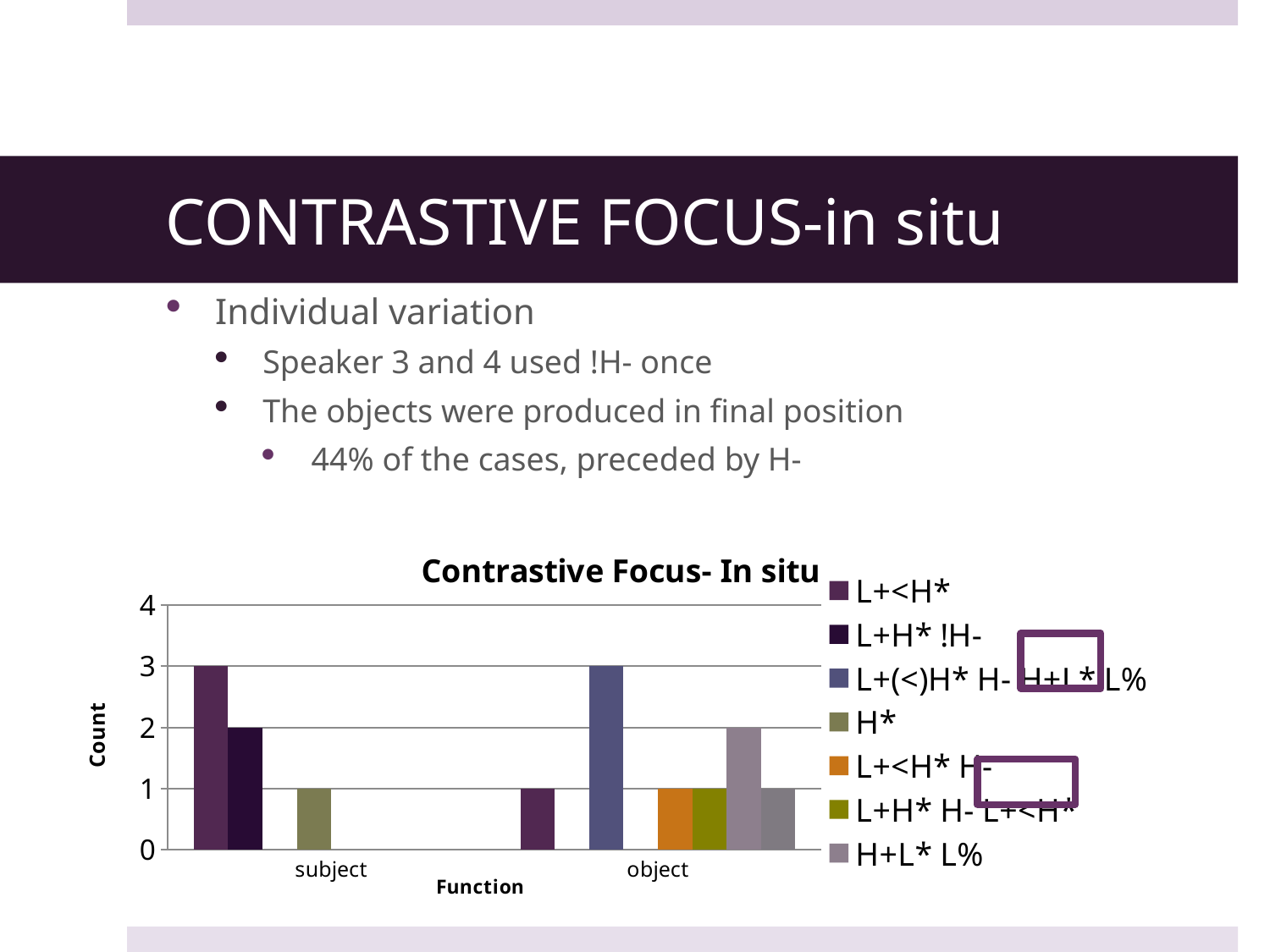
What is the label of the vertical axis of the chart? Count What is the count for L+<H* in the subject category? 3 What is the difference between the count for L+<H* in the subject category and in the object category? 2 What is the count for L+<H* in the object category? 1 What is the count for H+L* L% in the object category? 2 What is the title of the chart? Contrastive Focus- In situ Which is larger in the subject category: the count for L+<H* or the count for H*? L+<H* How many categories are shown on the x axis of the chart? 2 What is the count for L+(<)H* H- H+L* L% in the object category? 3 Which series has the highest count in the subject category? L+<H* What kind of chart is shown on the slide? bar chart What is the count for L+H* !H- in the subject category? 2